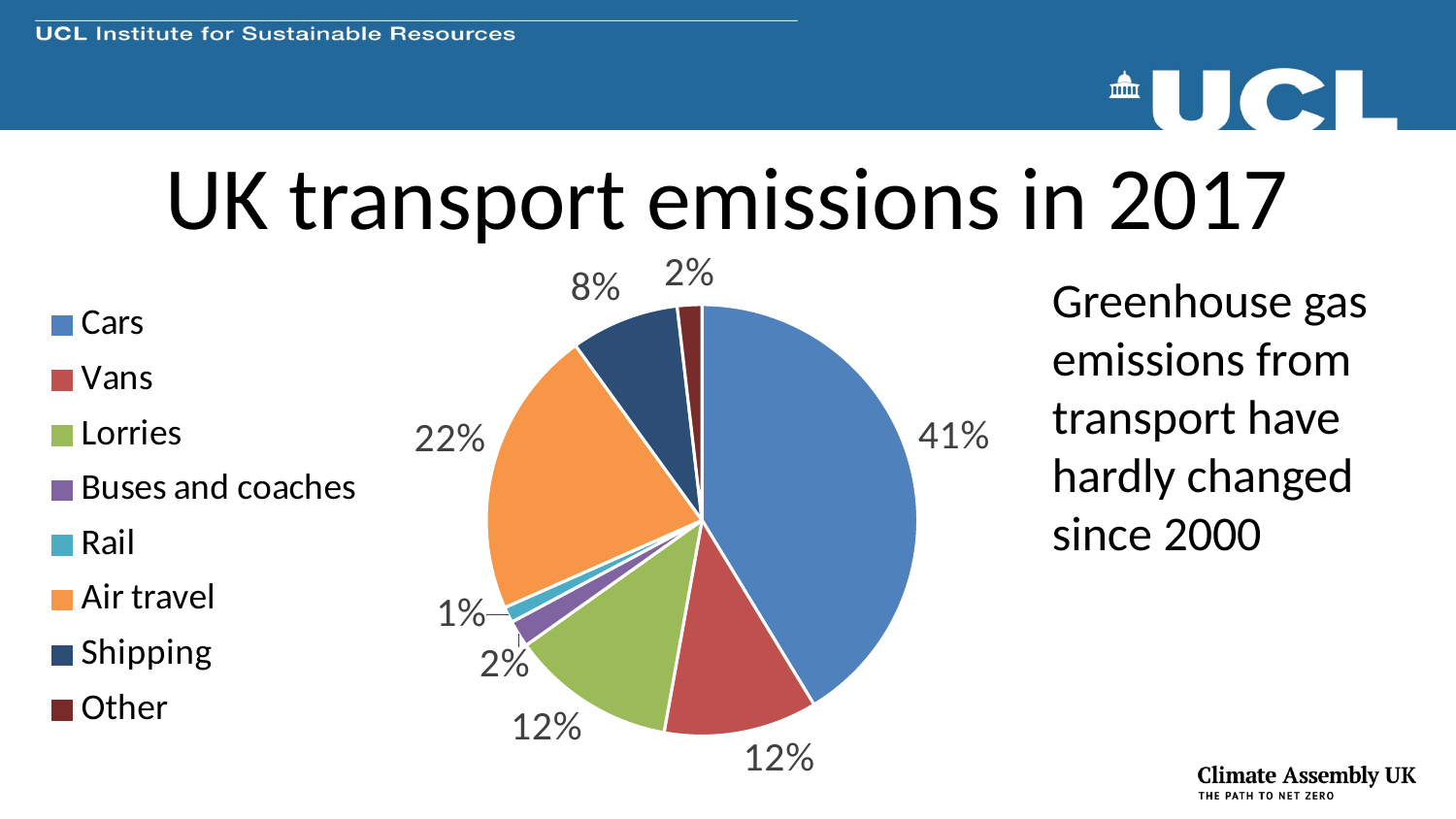
Which category has the largest slice of the pie? Cars What type of chart is shown on the slide? Pie chart What share of UK transport emissions in 2017 came from cars? 41% What share of emissions is shown for shipping? 8% How many percentage points larger is the cars slice than the air travel slice? 19 Which category has the smallest slice of the pie? Rail How many categories are listed in the legend of the pie chart? 8 What is the difference in percentage points between air travel and shipping? 14 What percentage does rail account for in the pie chart? 1% What is the title of the chart on the slide? UK transport emissions in 2017 Which is larger, the share for vans or the share for shipping? Vans What percentage of the pie is attributed to air travel? 22%